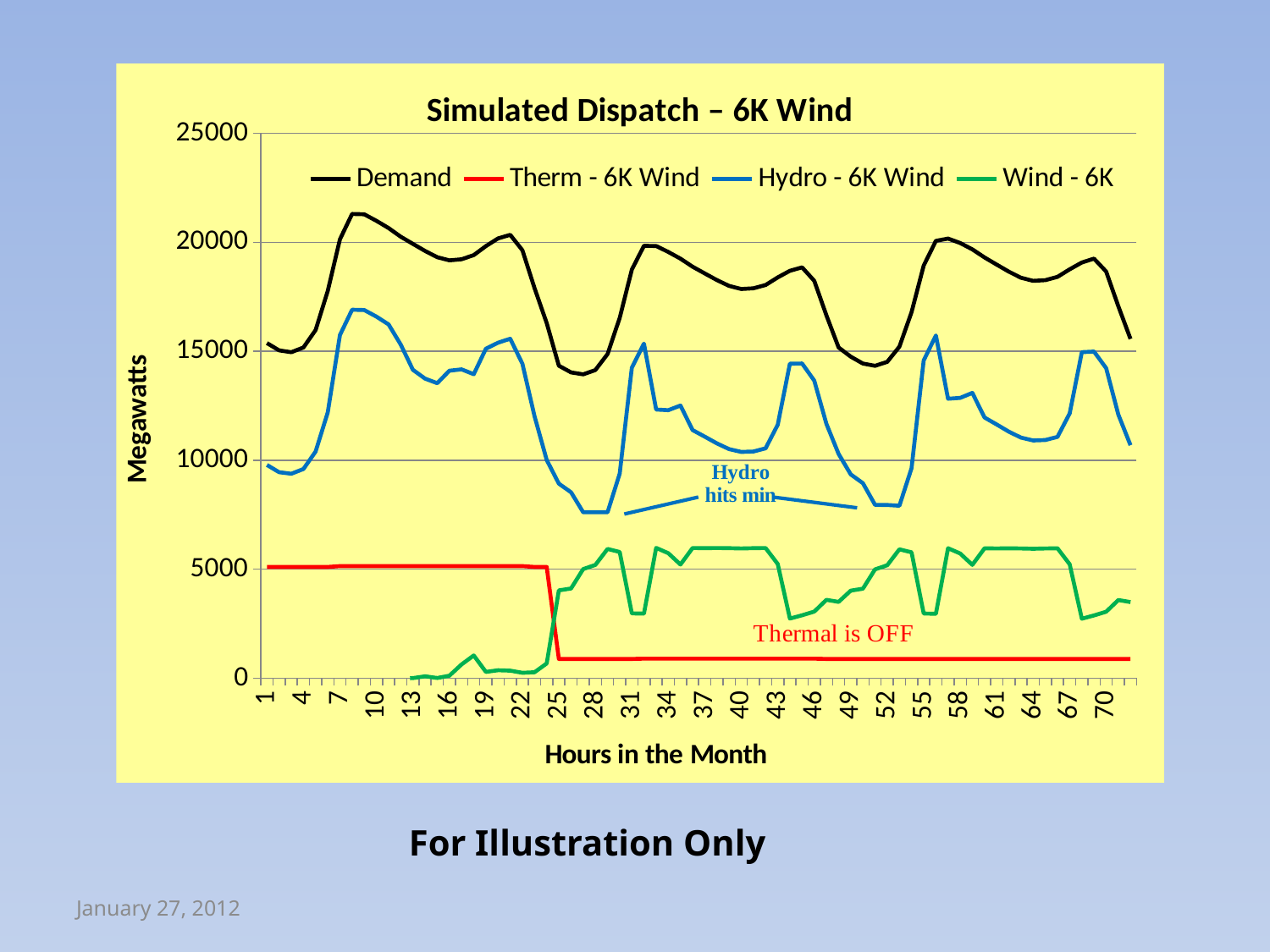
At hour 10, which series has the larger value, Therm - 6K Wind or Wind - 6K? Therm - 6K Wind Is the Therm - 6K Wind value at hour 40 greater or less than 5000? less At hour 40, which series has the larger value, Demand or Hydro - 6K Wind? Demand What is the label of the vertical axis? Megawatts How many series does the legend list? 4 Does the Therm - 6K Wind series rise or fall between hour 22 and hour 28? fall Is the Demand value at hour 28 greater or less than 15000? less What kind of chart is shown on the slide? line chart Is the Hydro - 6K Wind value at hour 28 greater or less than 10000? less What is the title of the chart? Simulated Dispatch – 6K Wind